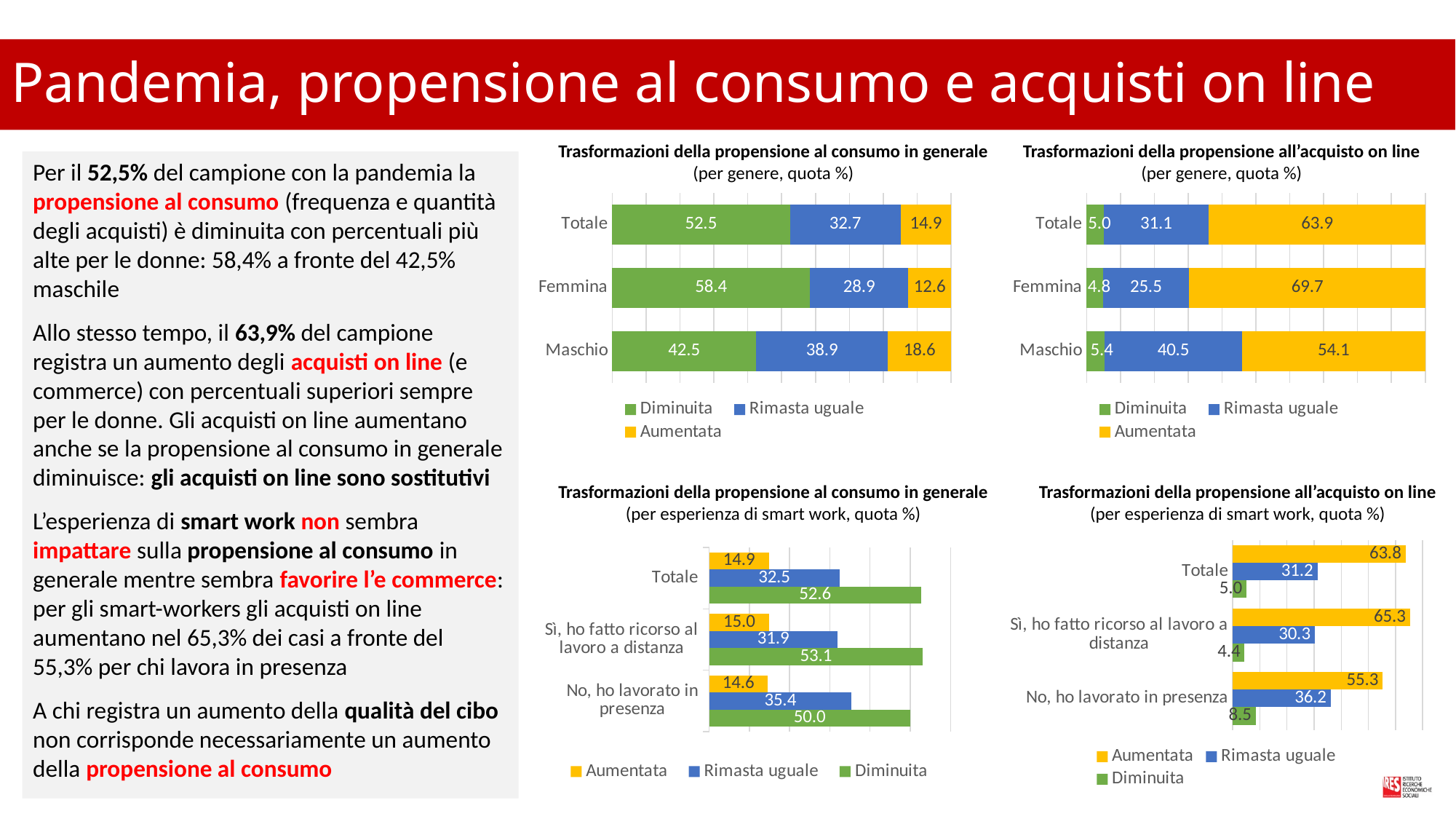
In the top-left chart (propensione al consumo in generale, per genere), what is the difference between the Aumentata values for Maschio and Femmina? 6.0 In the bottom-right chart (propensione all'acquisto on line, per esperienza di smart work), what is the Aumentata value for 'Sì, ho fatto ricorso al lavoro a distanza'? 65.3 In the top-right chart (propensione all'acquisto on line, per genere), which category has the lowest Diminuita value? Femmina In the top-left chart (Trasformazioni della propensione al consumo in generale, per genere), what is the Diminuita value for Femmina? 58.4 In the bottom-right chart (propensione all'acquisto on line, per esperienza di smart work), what is the difference between the Aumentata values for 'Sì, ho fatto ricorso al lavoro a distanza' and 'No, ho lavorato in presenza'? 10.0 In the top-right chart (propensione all'acquisto on line, per genere), is the Rimasta uguale value larger for Maschio or for Femmina? Maschio In the bottom-left chart (propensione al consumo in generale, per esperienza di smart work), which category has the highest Rimasta uguale value? No, ho lavorato in presenza In the top-left chart (propensione al consumo in generale, per genere), which category has the highest Diminuita value? Femmina How many series does the legend of the top-right chart (propensione all'acquisto on line, per genere) list? 3 In the bottom-left chart (propensione al consumo in generale, per esperienza di smart work), what is the Diminuita value for 'No, ho lavorato in presenza'? 50.0 What kind of chart is the bottom-right chart (propensione all'acquisto on line, per esperienza di smart work)? Bar chart In the top-right chart (Trasformazioni della propensione all'acquisto on line, per genere), what is the Aumentata value for Maschio? 54.1